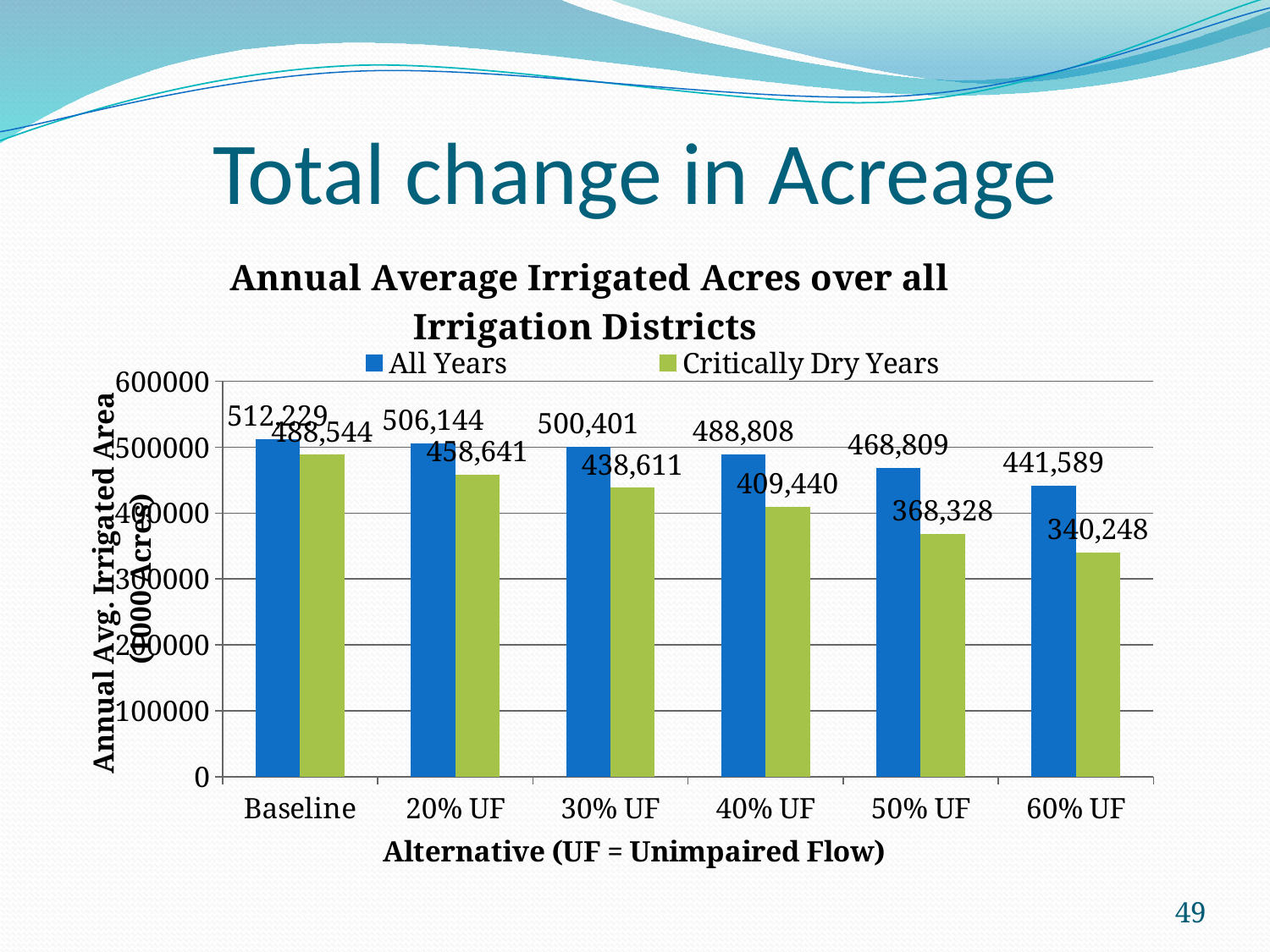
Which is larger: the Critically Dry Years value for 30% UF or the Critically Dry Years value for 40% UF? 30% UF Do the All Years values rise or fall from Baseline to 60% UF? fall Which alternative has the lowest Critically Dry Years value? 60% UF What is the difference between the All Years and Critically Dry Years values for 40% UF? 79,368 How many alternatives are shown on the x axis? 6 What is the All Years value for 30% UF? 500,401 Which alternative has the highest All Years value? Baseline What is the All Years value for 60% UF? 441,589 How many series does the legend list? 2 Is the Critically Dry Years value for 60% UF greater or less than 400000? less What is the Critically Dry Years value for 20% UF? 458,641 What is the Critically Dry Years value for 50% UF? 368,328